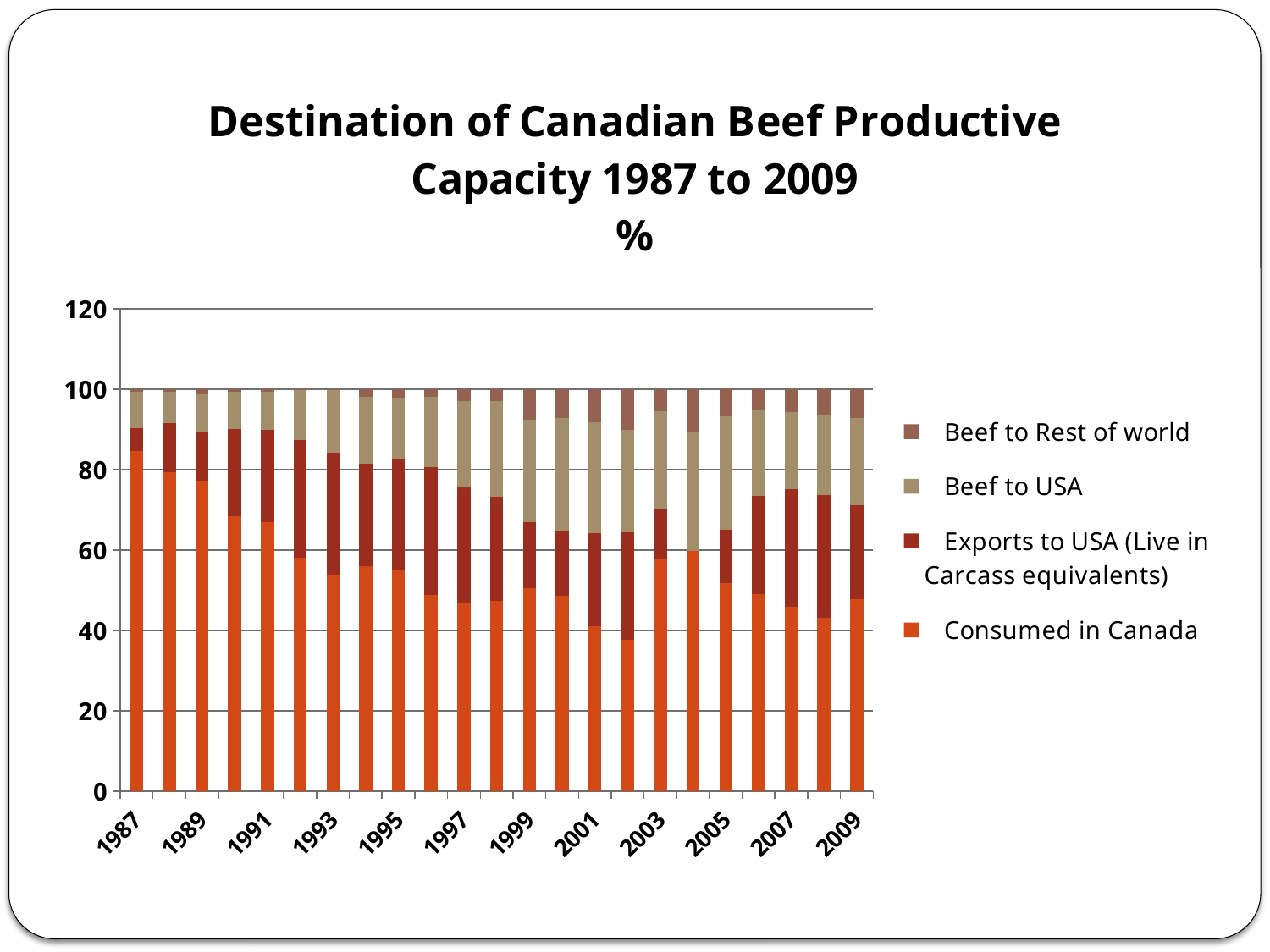
Is the value for Consumed in Canada in 1991 greater or less than 60? greater Which is larger, the Consumed in Canada value for 1987 or for 2009? 1987 How many years (bars) are plotted on the chart? 23 Does the Consumed in Canada share generally rise or fall from 1987 to 2009? Fall Is the value for Consumed in Canada in 2008 greater or less than 60? less What is the title of the chart? Destination of Canadian Beef Productive Capacity 1987 to 2009 % How many series does the legend list? 4 Which legend entry is shown in orange? Consumed in Canada What is the total height of the stacked bar for 1987? 100 Is the value for Consumed in Canada in 1987 greater or less than 80? greater What kind of chart is shown on the slide? Stacked bar chart Which year has the highest value for Consumed in Canada? 1987